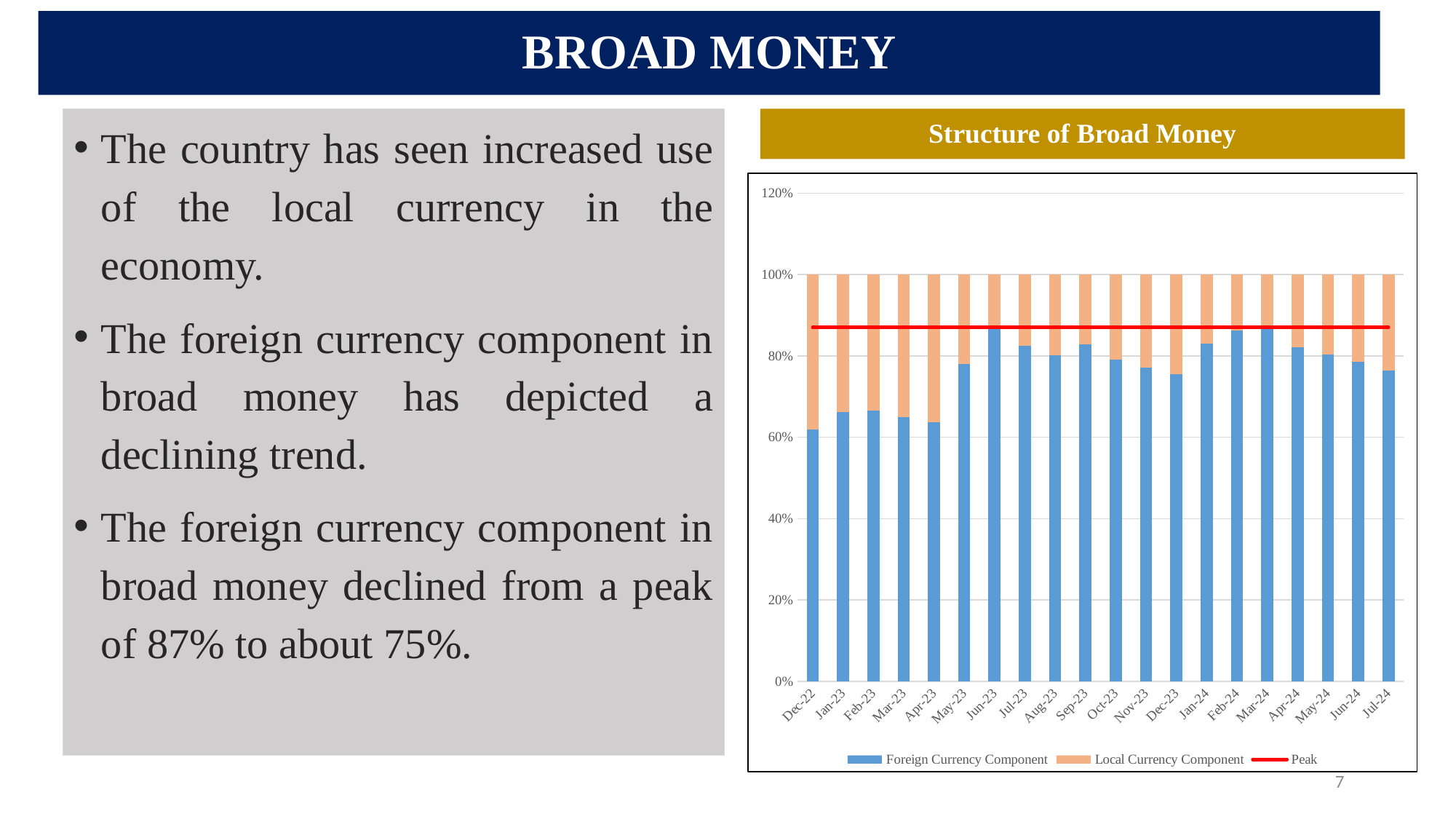
What kind of chart is shown on the slide? Stacked bar chart with a line (combination chart) Which month has the highest Local Currency Component? Dec-22 Does the Foreign Currency Component rise or fall from Mar-24 to Jul-24? Fall What is the title of the chart on the slide? Structure of Broad Money Is the Foreign Currency Component for Jun-23 greater or less than 80%? greater What is the total of the stacked bar for Dec-22? 100% Which is larger, the Foreign Currency Component for Dec-22 or for Jun-23? Jun-23 How many series does the chart legend list? 3 Is the Foreign Currency Component for Jul-24 greater or less than 80%? less Which month has the lowest Foreign Currency Component? Dec-22 Is the Foreign Currency Component for Dec-22 greater or less than 80%? less How many months are shown on the x axis of the chart? 20